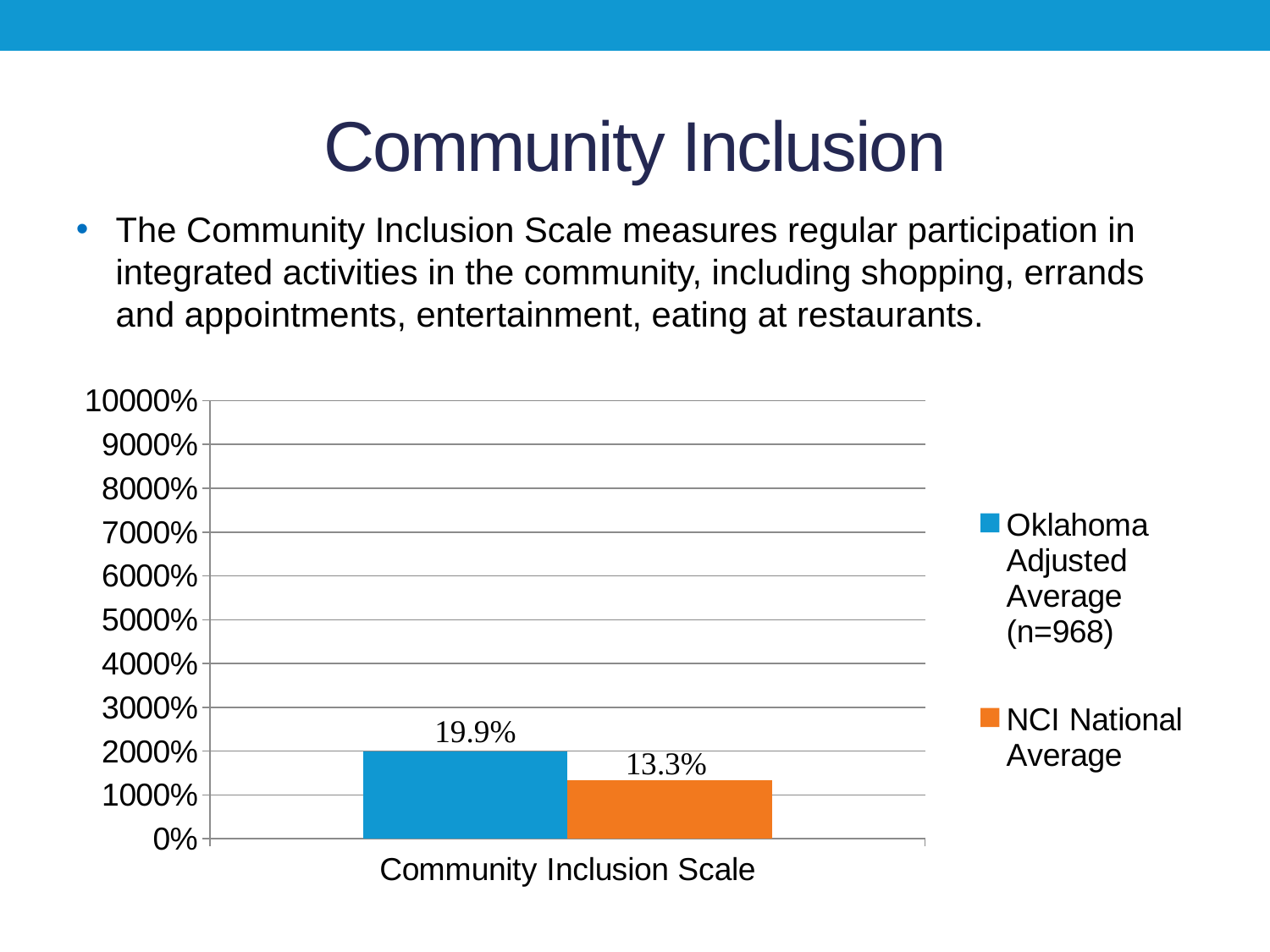
What kind of chart is shown on the slide? bar chart What colour is the bar for NCI National Average? orange Is the Oklahoma Adjusted Average larger or smaller than the NCI National Average? larger Which series has the higher value on the Community Inclusion Scale? Oklahoma Adjusted Average (n=968) Which series has the lower value on the Community Inclusion Scale? NCI National Average How many series does the legend list? 2 What is the value for Oklahoma Adjusted Average (n=968) on the Community Inclusion Scale? 19.9% How many categories are shown on the x axis of the chart? 1 What is the label of the category on the x axis? Community Inclusion Scale What is the difference between the Oklahoma Adjusted Average and the NCI National Average on the Community Inclusion Scale? 6.6% What is the value for NCI National Average on the Community Inclusion Scale? 13.3%